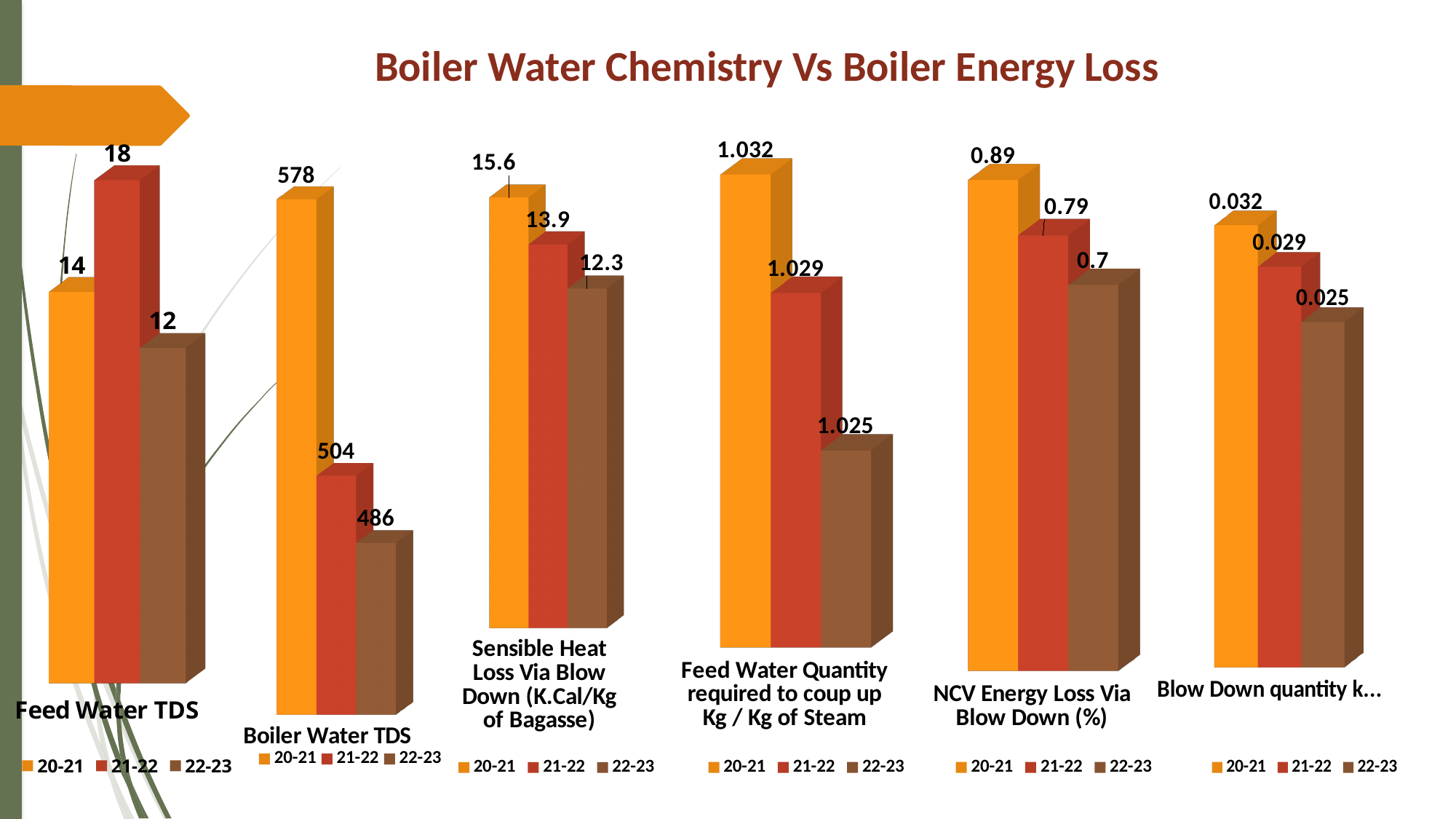
In the NCV Energy Loss Via Blow Down (%) chart, which series has the highest value? 20-21 In the Feed Water TDS chart, which series has the lowest value? 22-23 In the Boiler Water TDS chart, what is the value for 20-21? 578 In the Feed Water TDS chart, what is the value for 21-22? 18 In the Sensible Heat Loss Via Blow Down chart, what is the value for 22-23? 12.3 In the Boiler Water TDS chart, what is the difference between the 20-21 and 22-23 values? 92 In the Blow Down quantity chart (rightmost), what is the value for 22-23? 0.025 What kind of chart is the Feed Water TDS chart? bar chart In the Feed Water Quantity required to coup up Kg / Kg of Steam chart, what is the value for 21-22? 1.029 In the NCV Energy Loss Via Blow Down (%) chart, what is the difference between the 20-21 and 21-22 values? 0.1 How many series does the legend of the Boiler Water TDS chart list? 3 In the Sensible Heat Loss Via Blow Down chart, do the values rise or fall from 20-21 to 22-23? fall